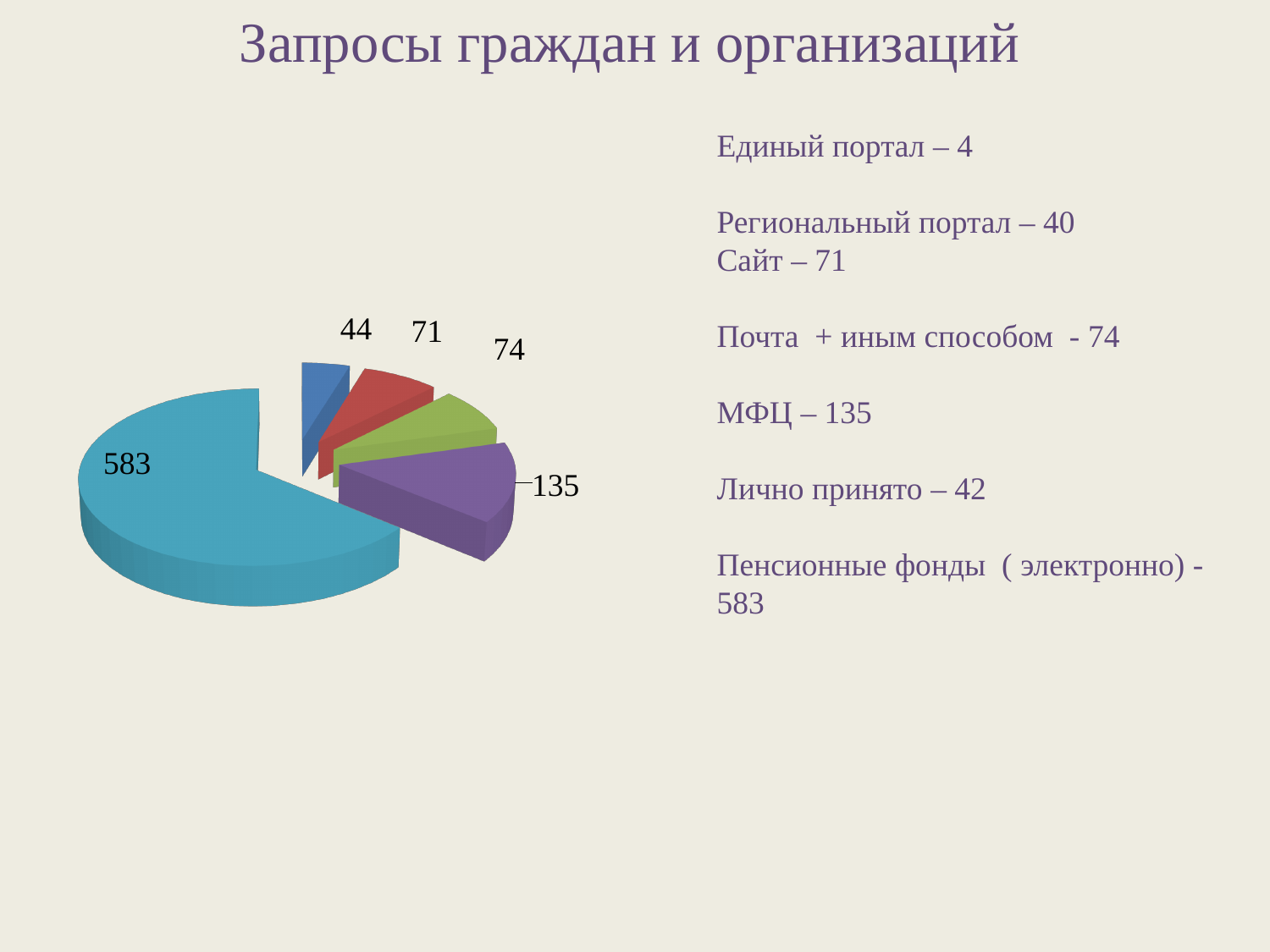
What is the total of all the values labelled on the pie chart? 907 What is the value of the largest slice in the pie chart? 583 What colour is the largest slice of the pie chart? Teal (blue-green) What is the value of the smallest slice in the pie chart? 44 What is the value of the blue slice at the top of the pie chart? 44 What kind of chart is shown on the slide? Pie chart What is the value of the purple slice in the pie chart? 135 What is the title of the slide containing the pie chart? Запросы граждан и организаций How many slices does the pie chart have? 5 Which is larger: the slice labelled 135 or the slice labelled 74? 135 What is the difference between the largest slice (583) and the second-largest slice (135)? 448 What is the difference between the slices labelled 74 and 71? 3